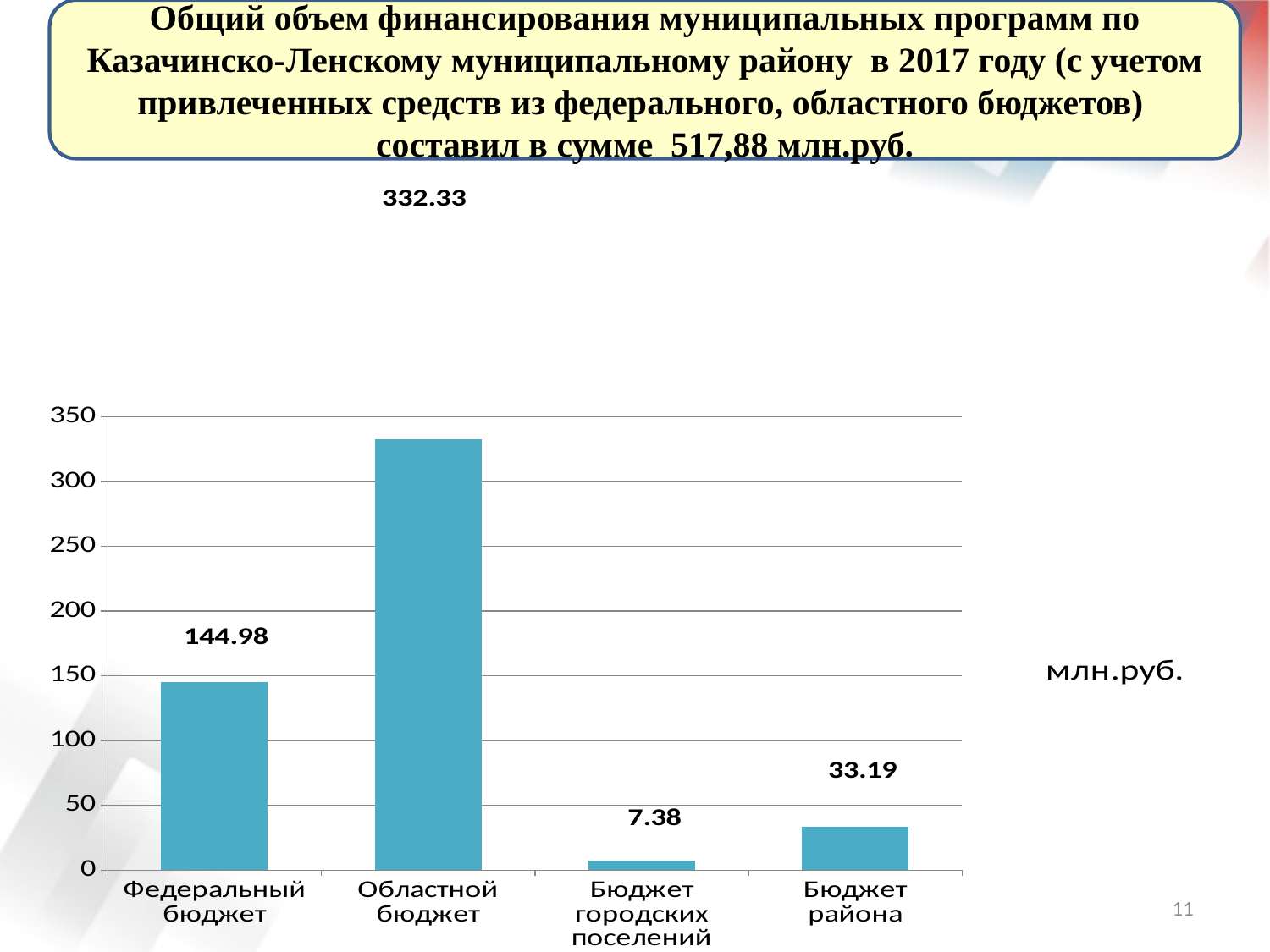
What is the value for Бюджет района? 33.19 What is the value for Федеральный бюджет? 144.98 Which is larger, Федеральный бюджет or Бюджет района? Федеральный бюджет What is the value for Областной бюджет? 332.33 Which category has the lowest value? Бюджет городских поселений Which category has the highest value? Областной бюджет What kind of chart is shown on the slide? bar chart According to the slide title, what was the total funding of municipal programs in 2017? 517,88 млн.руб. What is the value for Бюджет городских поселений? 7.38 How many categories are shown in the chart? 4 What is the difference between Областной бюджет and Федеральный бюджет? 187.35 What is the difference between Бюджет района and Бюджет городских поселений? 25.81